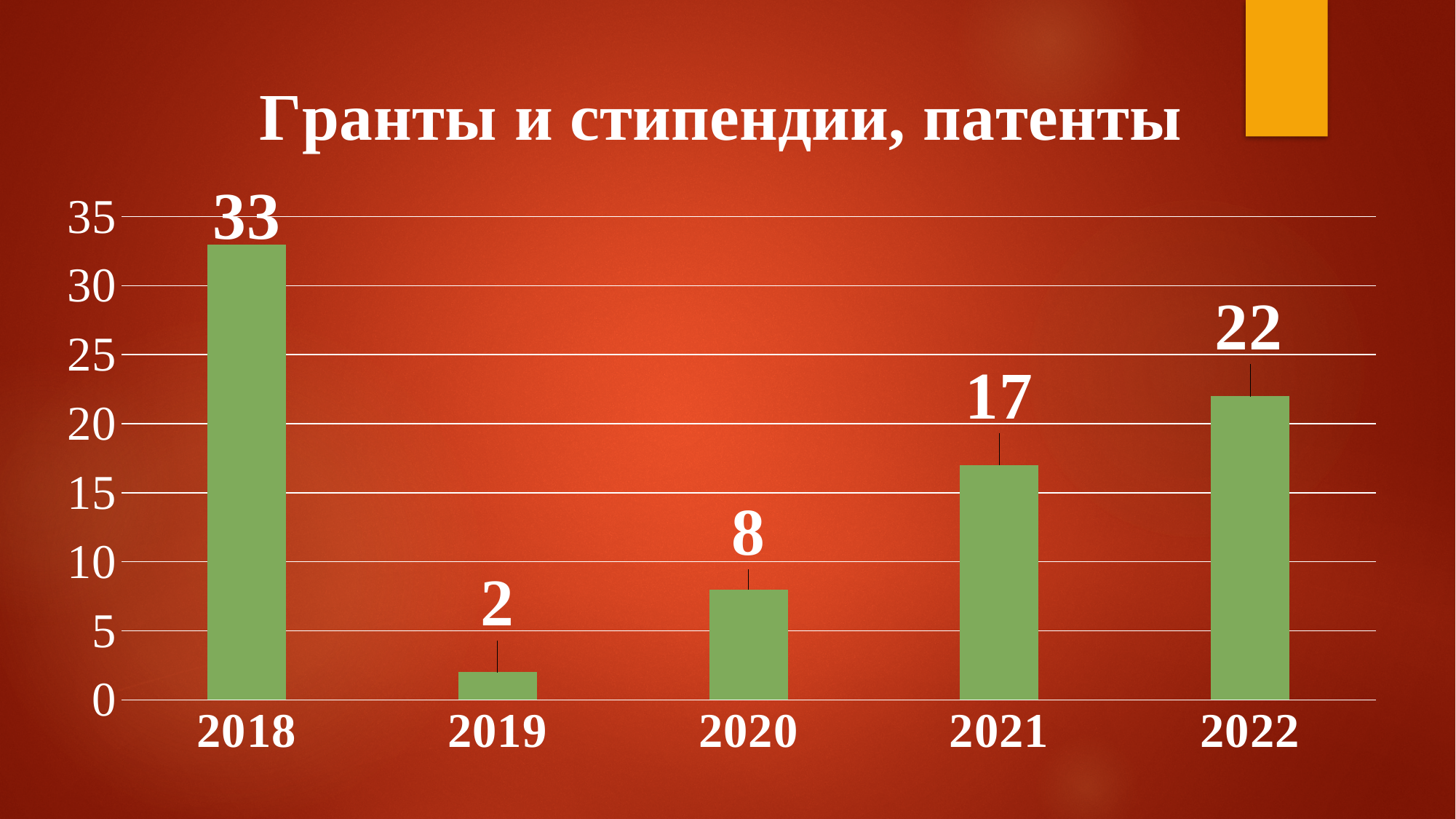
How many years are shown on the chart? 5 What is the value for 2022? 22 Which is larger, the value for 2020 or the value for 2021? 2021 What is the value for 2018? 33 Which year has the lowest value? 2019 What is the difference between the values for 2018 and 2022? 11 What kind of chart is shown on the slide? Bar chart What is the value for 2020? 8 What is the title of the chart? Гранты и стипендии, патенты What is the value for 2019? 2 What is the value for 2021? 17 Which year has the highest value? 2018